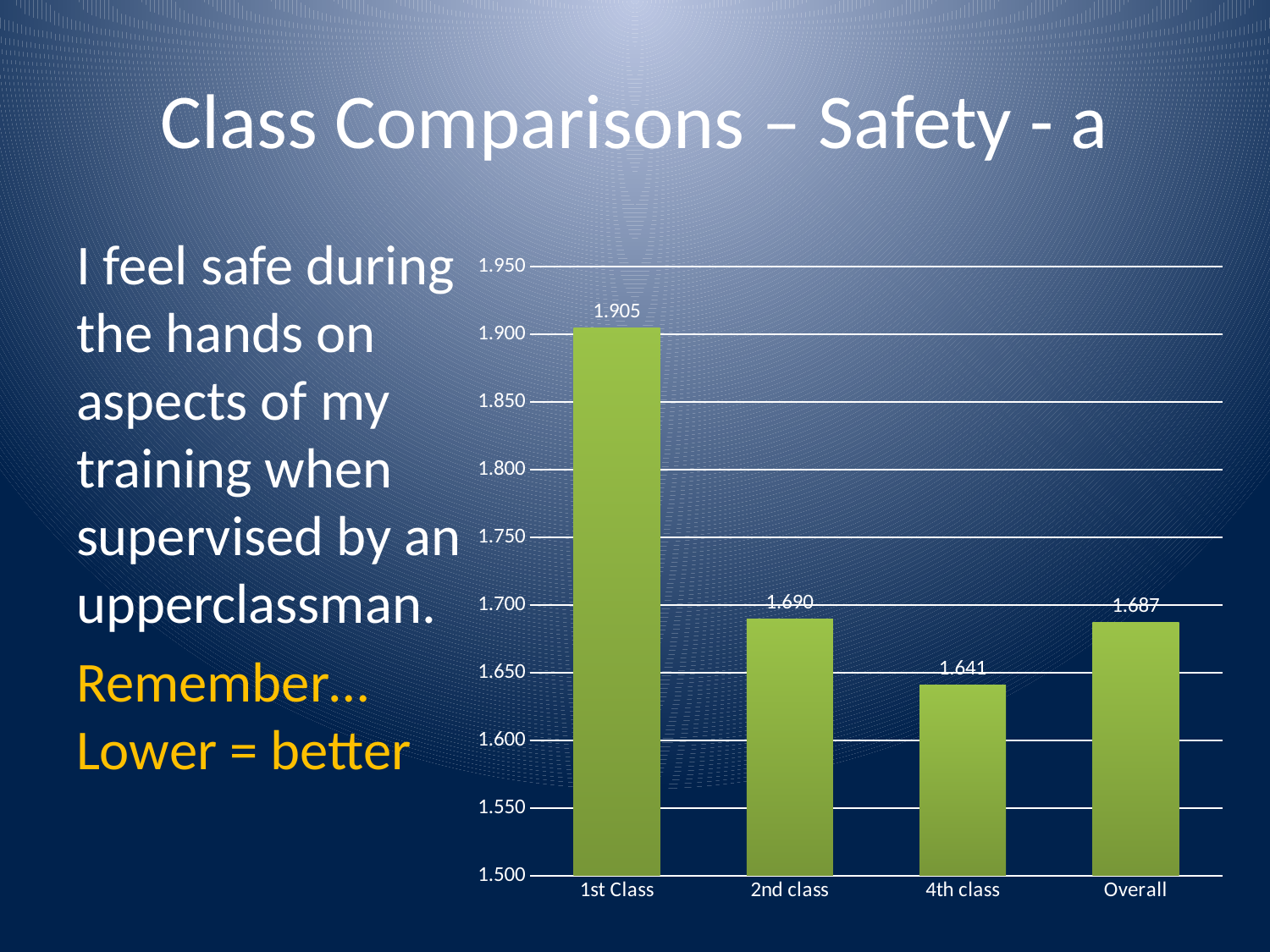
Which category has the highest value? 1st Class What is the value for Overall? 1.687 What is the difference between the values for 1st Class and 4th class? 0.264 Which category has the lowest value? 4th class Is the value for 4th class greater or less than 1.650? less What is the difference between the values for 2nd class and Overall? 0.003 What kind of chart is shown on the slide? bar chart How many categories are shown on the x axis? 4 What is the value for 1st Class? 1.905 Which is larger, the value for 1st Class or the value for 2nd class? 1st Class What is the value for 2nd class? 1.690 What is the value for 4th class? 1.641